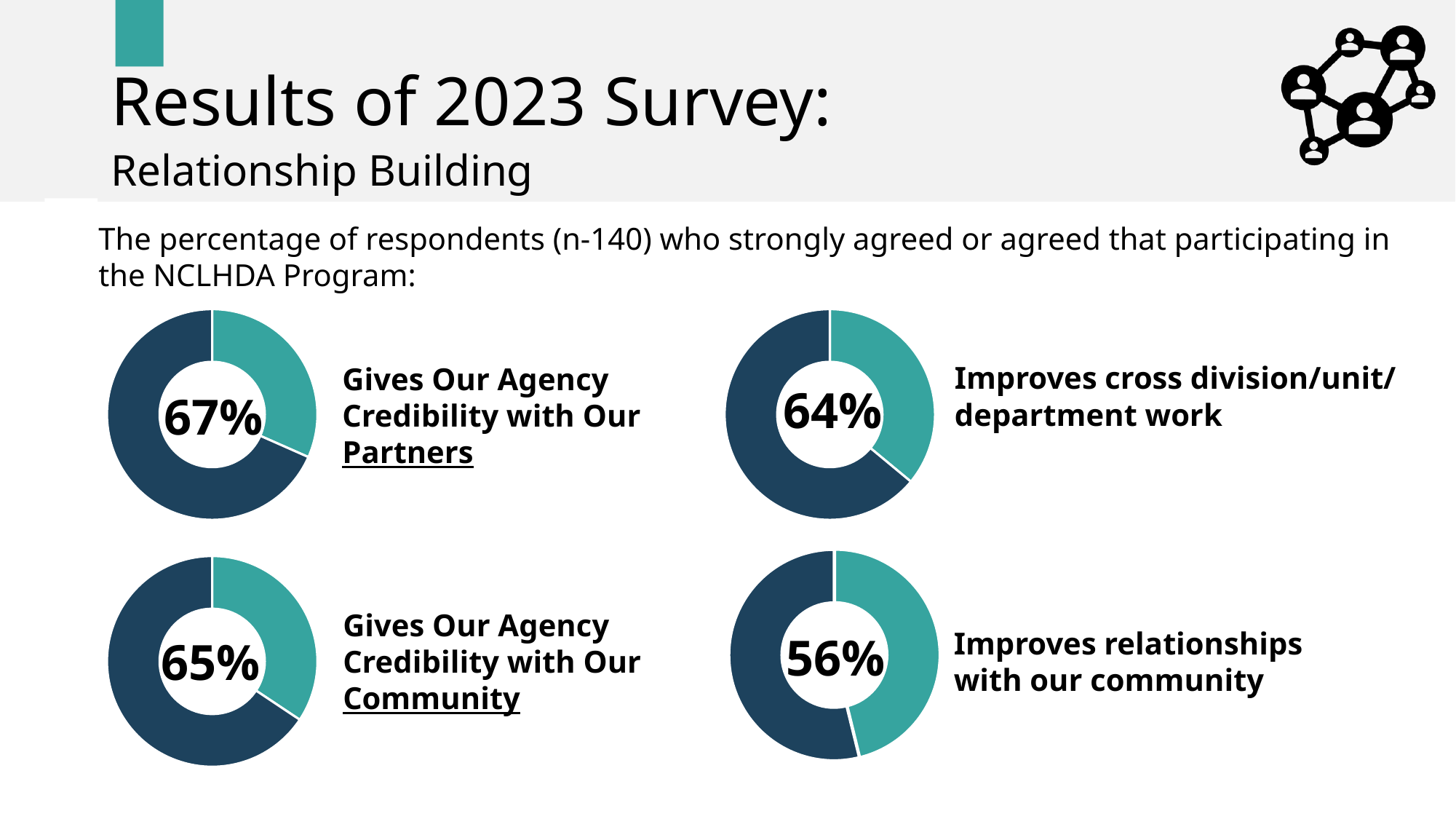
How many survey respondents (n) does the slide say the percentages are based on? 140 Which has a higher percentage: 'Gives Our Agency Credibility with Our Community' or 'Improves relationships with our community'? Gives Our Agency Credibility with Our Community What is the difference in percentage points between the 'Credibility with Our Community' value and the 'Improves cross division/unit/department work' value? 1 What percentage of respondents agreed that participating in the NCLHDA Program improves cross division/unit/department work? 64% What type of chart is used to display each percentage on the slide? Donut chart What is the difference in percentage points between the 'Credibility with Our Partners' value and the 'Improves relationships with our community' value? 11 How many donut charts are shown on the slide? 4 Which of the four relationship-building statements received the lowest percentage of agreement? Improves relationships with our community What percentage of respondents agreed that participating in the NCLHDA Program improves relationships with their community? 56% What percentage of respondents agreed that participating in the NCLHDA Program gives their agency credibility with their community? 65% Which of the four relationship-building statements received the highest percentage of agreement? Gives Our Agency Credibility with Our Partners What percentage of respondents agreed that participating in the NCLHDA Program gives their agency credibility with their partners? 67%